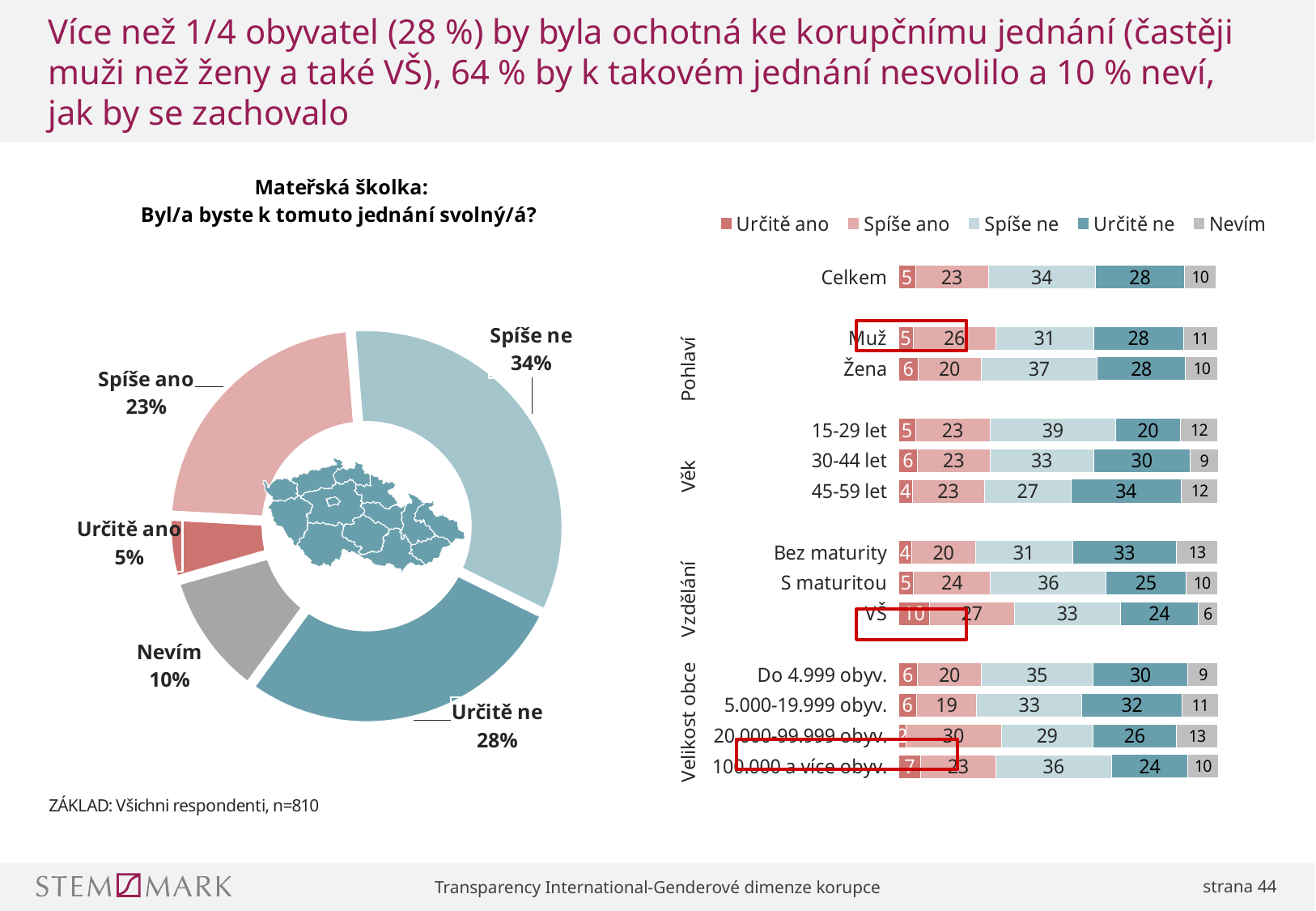
How many slices does the donut chart on the left have? 5 What kind of chart is the chart on the right? Stacked bar chart In the stacked bar chart on the right, what is the "Spíše ne" value for "Žena"? 37 In the stacked bar chart on the right, what is the "Spíše ne" value for "15-29 let"? 39 In the donut chart on the left, which category has the largest share? Spíše ne In the stacked bar chart on the right, which has the larger "Určitě ne" value: "45-59 let" or "15-29 let"? 45-59 let In the stacked bar chart on the right, what is the difference between the "Spíše ano" values for "Muž" and "Žena"? 6 How many series does the legend of the stacked bar chart on the right list? 5 In the donut chart on the left, what is the value for "Spíše ne"? 34% In the donut chart on the left, which category has the smallest share? Určitě ano What kind of chart is the chart on the left titled "Mateřská školka: Byl/a byste k tomuto jednání svolný/á?"? Donut (pie) chart In the donut chart on the left, what is the difference between "Spíše ne" and "Určitě ne"? 6 percentage points